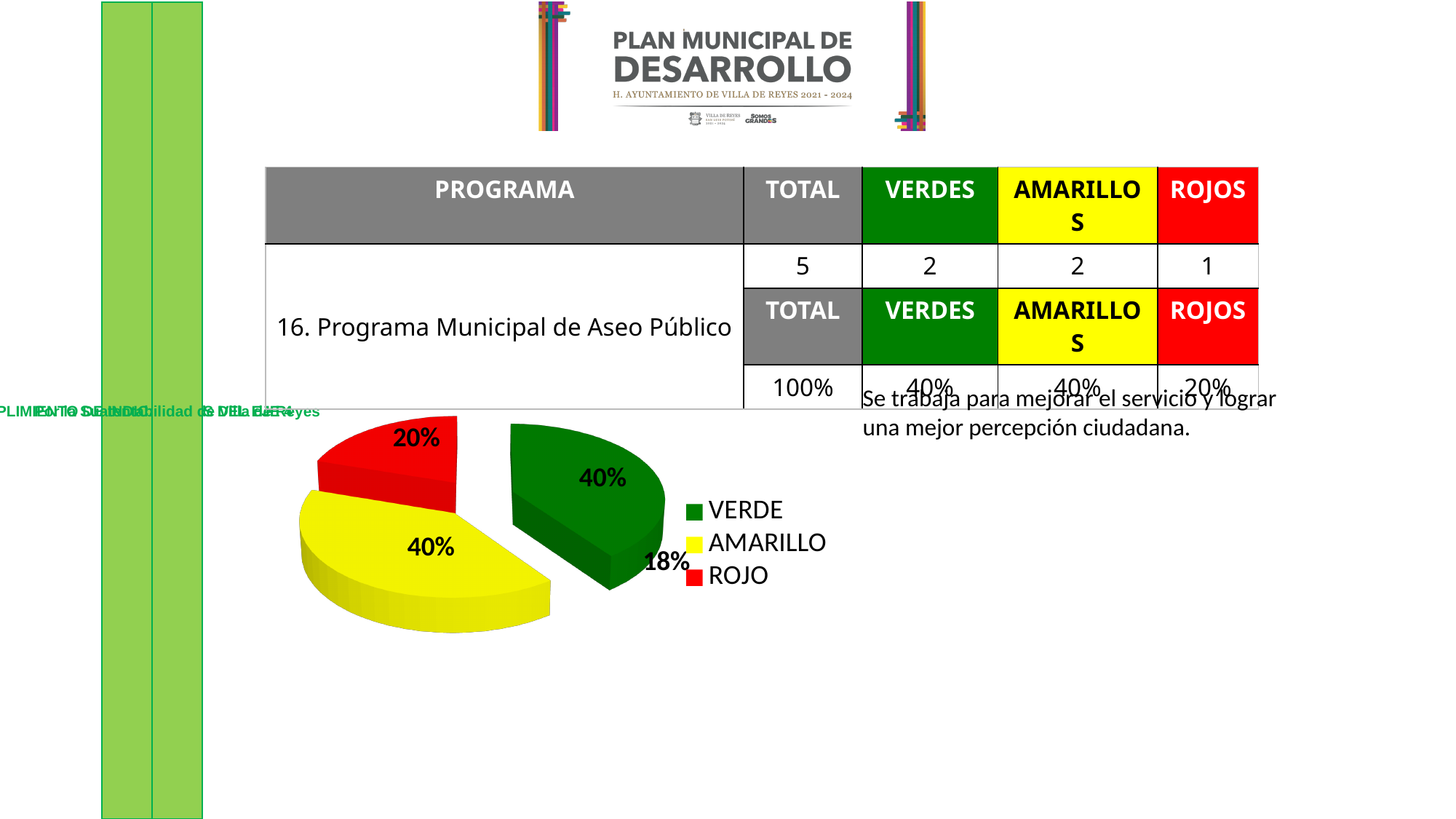
By how many percentage points does the AMARILLO slice exceed the ROJO slice in the pie chart? 20 How many entries does the pie chart's legend list? 3 What kind of chart is shown on the slide? pie chart What colour is the ROJO slice in the pie chart? red What are the three legend entries of the pie chart? VERDE, AMARILLO, ROJO What percentage does the VERDE slice of the pie chart show? 40% What percentage does the AMARILLO slice of the pie chart show? 40% Which slice of the pie chart is the smallest? ROJO How many slices does the pie chart have? 3 Which is larger in the pie chart, the VERDE slice or the ROJO slice? VERDE What percentage does the ROJO slice of the pie chart show? 20%